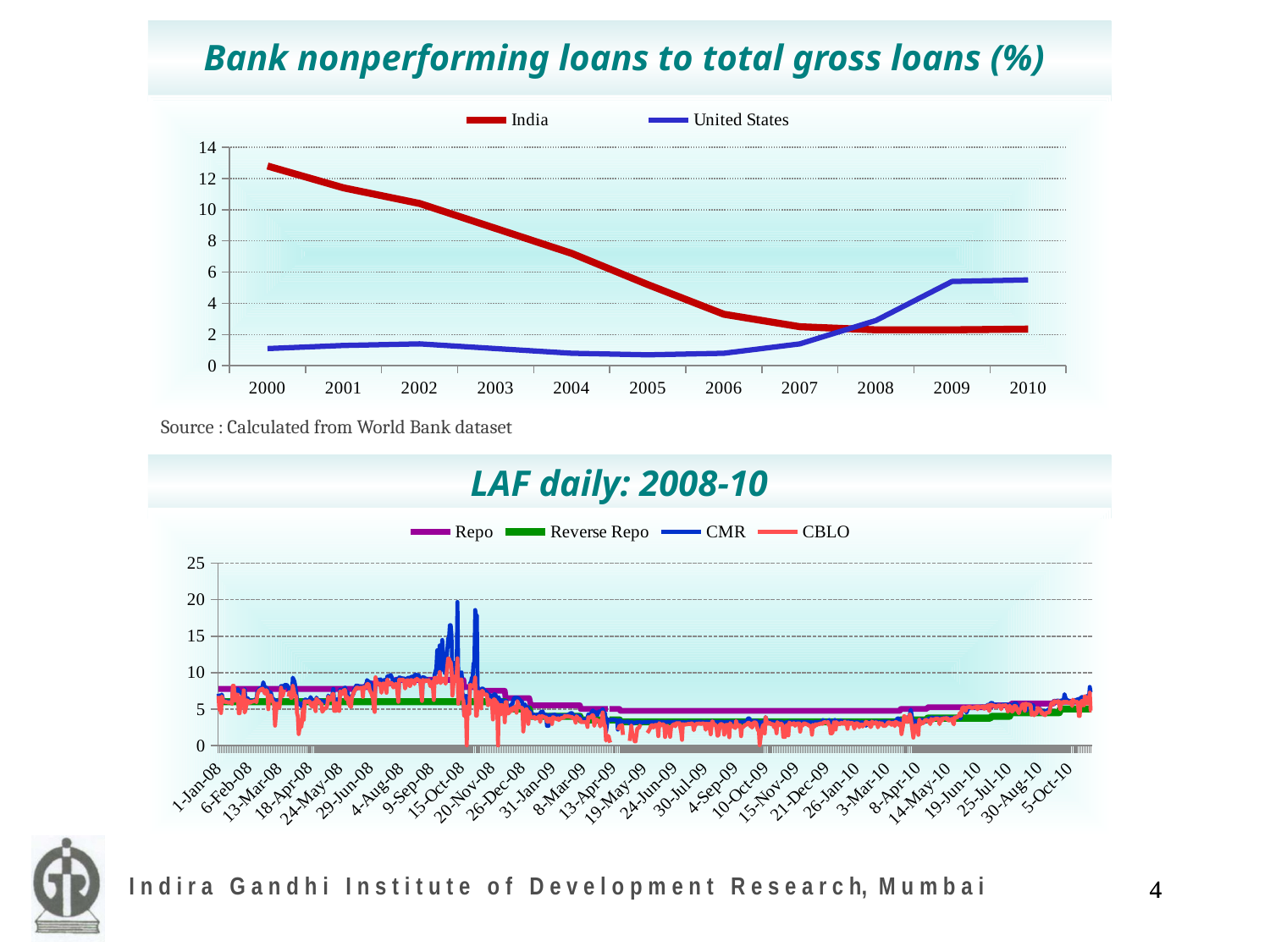
In the 'LAF daily: 2008-10' chart, which colour is used for the Reverse Repo series? Green In the 'Bank nonperforming loans to total gross loans (%)' chart, does the India line rise or fall from 2000 to 2010? Fall How many series does the legend of the 'LAF daily: 2008-10' chart list? 4 In the 'Bank nonperforming loans to total gross loans (%)' chart, in which year is the India value highest? 2000 In the 'Bank nonperforming loans to total gross loans (%)' chart, is the value for the United States in 2009 greater or less than 4? greater In the 'Bank nonperforming loans to total gross loans (%)' chart, is the value for the United States in 2000 greater or less than 2? less In the 'Bank nonperforming loans to total gross loans (%)' chart, which series has the larger value in 2010, India or United States? United States In the 'Bank nonperforming loans to total gross loans (%)' chart, is the value for India in 2000 greater or less than 12? greater How many series does the legend of the 'Bank nonperforming loans to total gross loans (%)' chart list? 2 What kind of chart is the 'Bank nonperforming loans to total gross loans (%)' chart? Line chart How many years are shown on the x axis of the 'Bank nonperforming loans to total gross loans (%)' chart? 11 In the 'Bank nonperforming loans to total gross loans (%)' chart, which series has the larger value in 2003, India or United States? India